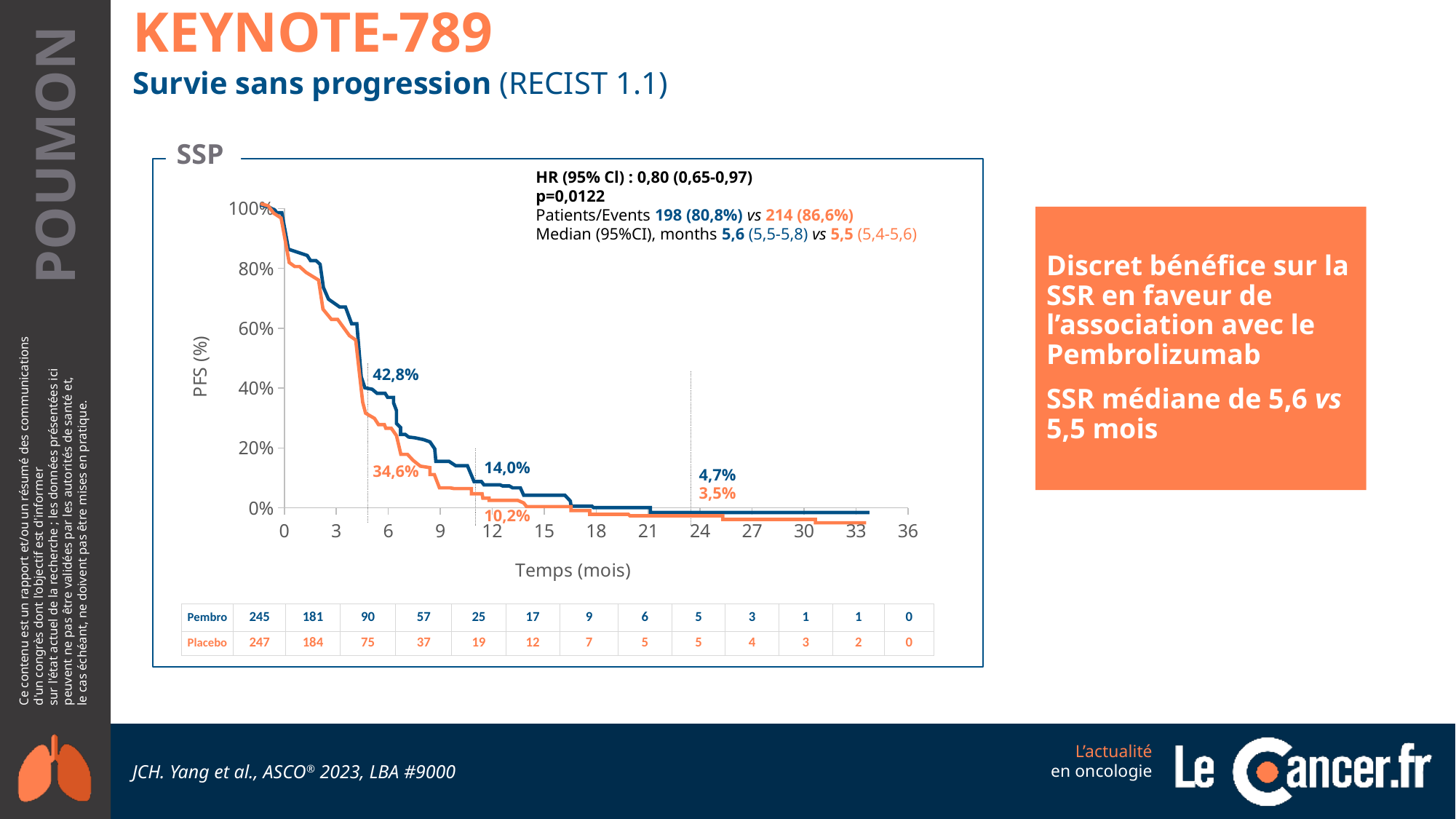
What is the label of the x axis of the chart? Temps (mois) What is the PFS rate labelled for the Pembro arm at the second dotted landmark line? 14,0% What kind of chart is shown in the SSP panel? line chart What is the PFS rate labelled for the Placebo arm at the first dotted landmark line? 34,6% At the third landmark line, which arm has the higher labelled PFS rate, Pembro or Placebo? Pembro What is the median PFS in months reported for the Pembro arm? 5,6 What is the difference in percentage points between the Pembro and Placebo PFS rates at the first landmark (42,8% vs 34,6%)? 8,2 points What is the PFS rate labelled for the Placebo arm at the third dotted landmark line? 3,5% What is the PFS rate labelled for the Placebo arm at the second dotted landmark line? 10,2% What is the PFS rate labelled for the Pembro arm at the first dotted landmark line? 42,8% Do the PFS curves rise or fall as time increases along the x axis? fall How many patients are at risk in the Pembro arm at time 0 according to the table below the chart? 245